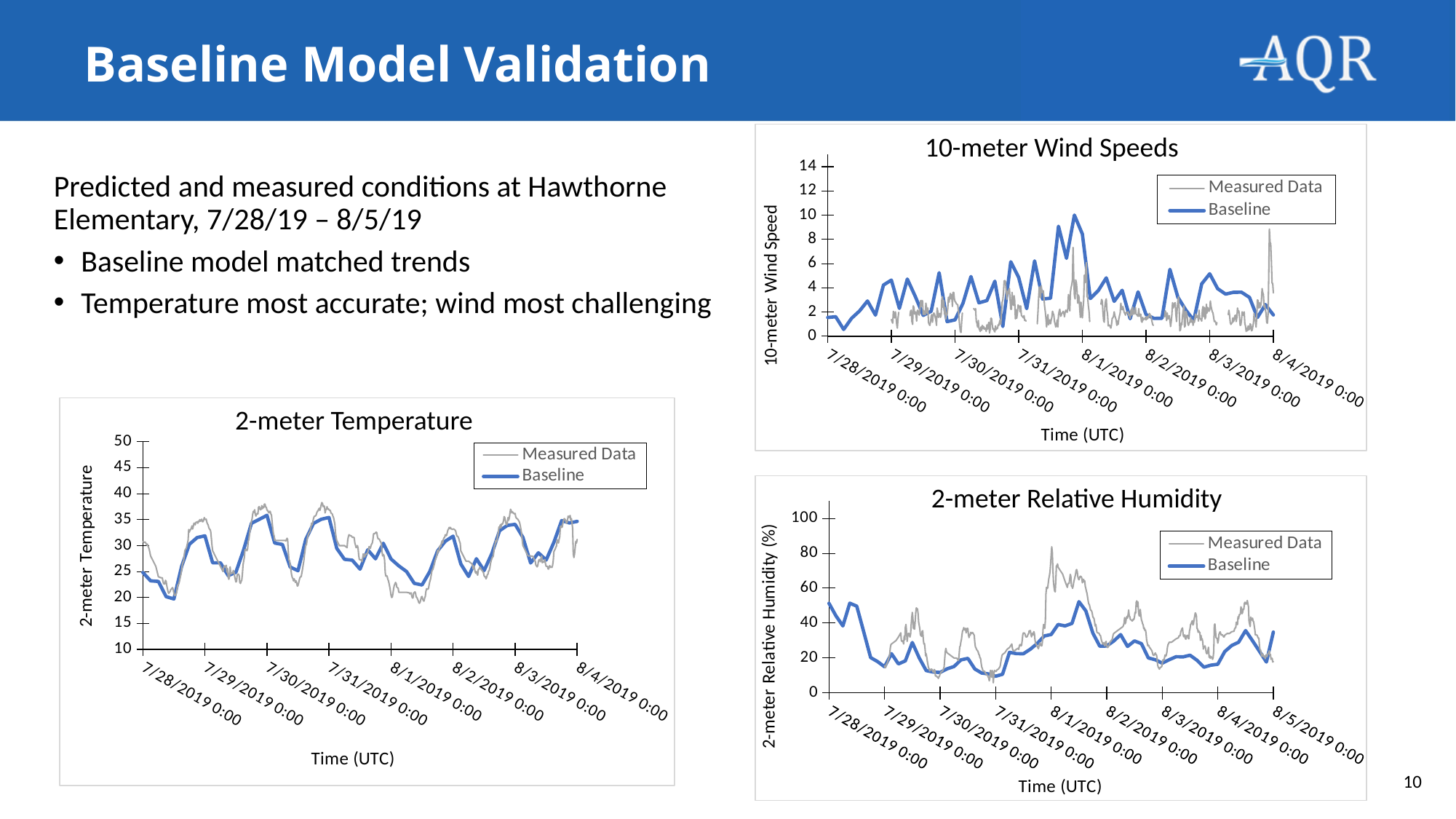
In the "2-meter Relative Humidity" chart, is the highest Measured Data value greater or less than 60? greater How many series does the legend of the "2-meter Temperature" chart list? 2 In the "10-meter Wind Speeds" chart, is the Baseline value at 7/28/2019 0:00 greater or less than 4? less In the "2-meter Relative Humidity" chart, which two series are listed in the legend? Measured Data and Baseline In the "2-meter Temperature" chart, is the lowest Baseline value greater or less than 25? less How many date labels are shown on the x axis of the "2-meter Temperature" chart? 8 What is the x-axis title of the "10-meter Wind Speeds" chart? Time (UTC) How many date labels are shown on the x axis of the "2-meter Relative Humidity" chart? 9 What kind of chart is the "10-meter Wind Speeds" chart? line chart